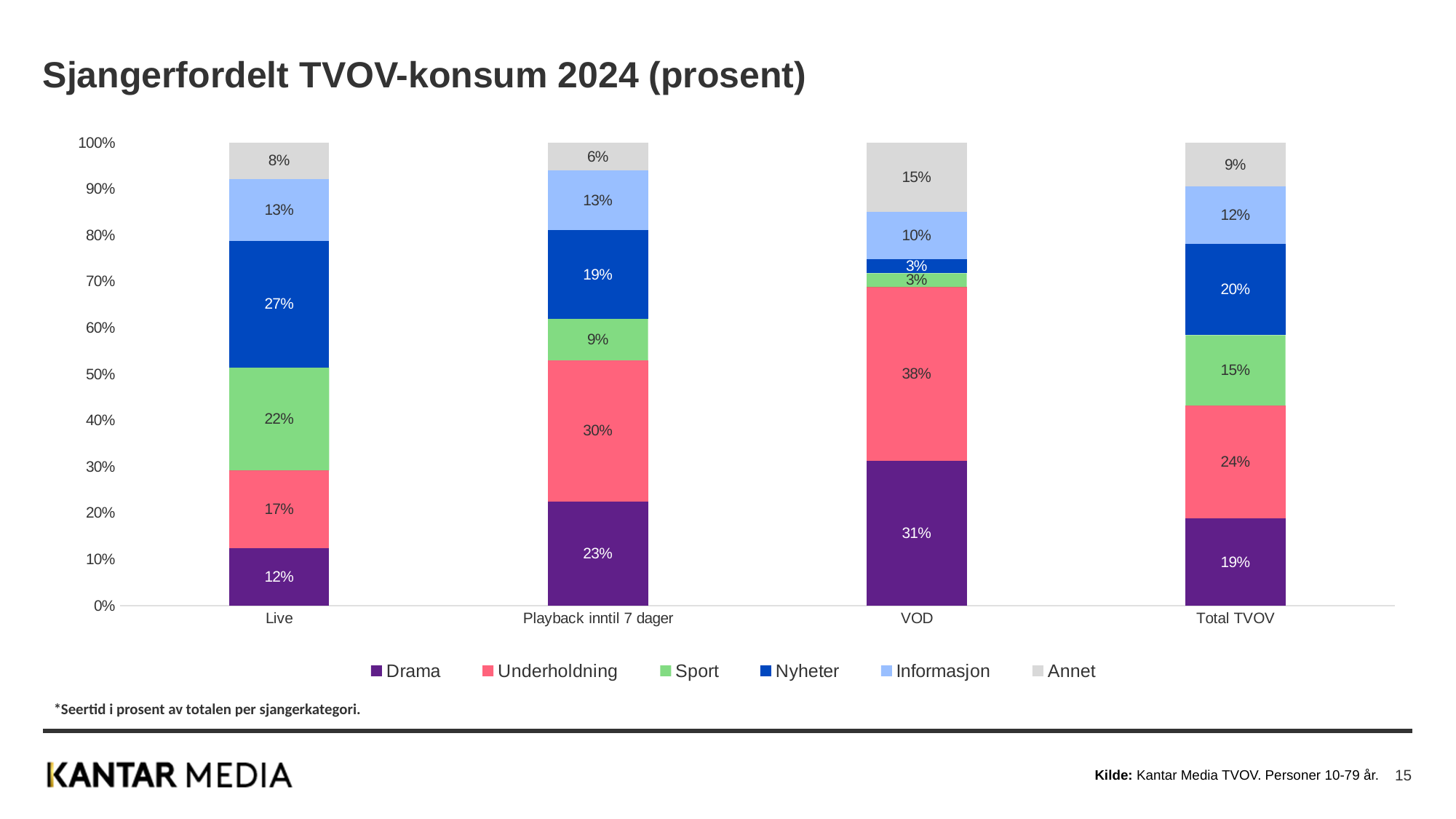
What is the value for Sport in the Total TVOV bar? 15% How many categories are shown on the x axis? 4 How many series does the legend list? 6 Which is larger: Nyheter for Playback inntil 7 dager or Nyheter for Total TVOV? Total TVOV What is the value for Underholdning in the VOD bar? 38% Which category has the lowest value for Sport? VOD What is the title of the chart? Sjangerfordelt TVOV-konsum 2024 (prosent) Which category has the highest value for Annet? VOD What is the value for Drama in the Playback inntil 7 dager bar? 23% What is the difference between the Drama values for VOD and Live? 19% What is the value for Nyheter in the Live bar? 27% What kind of chart is shown on the slide? Stacked bar chart